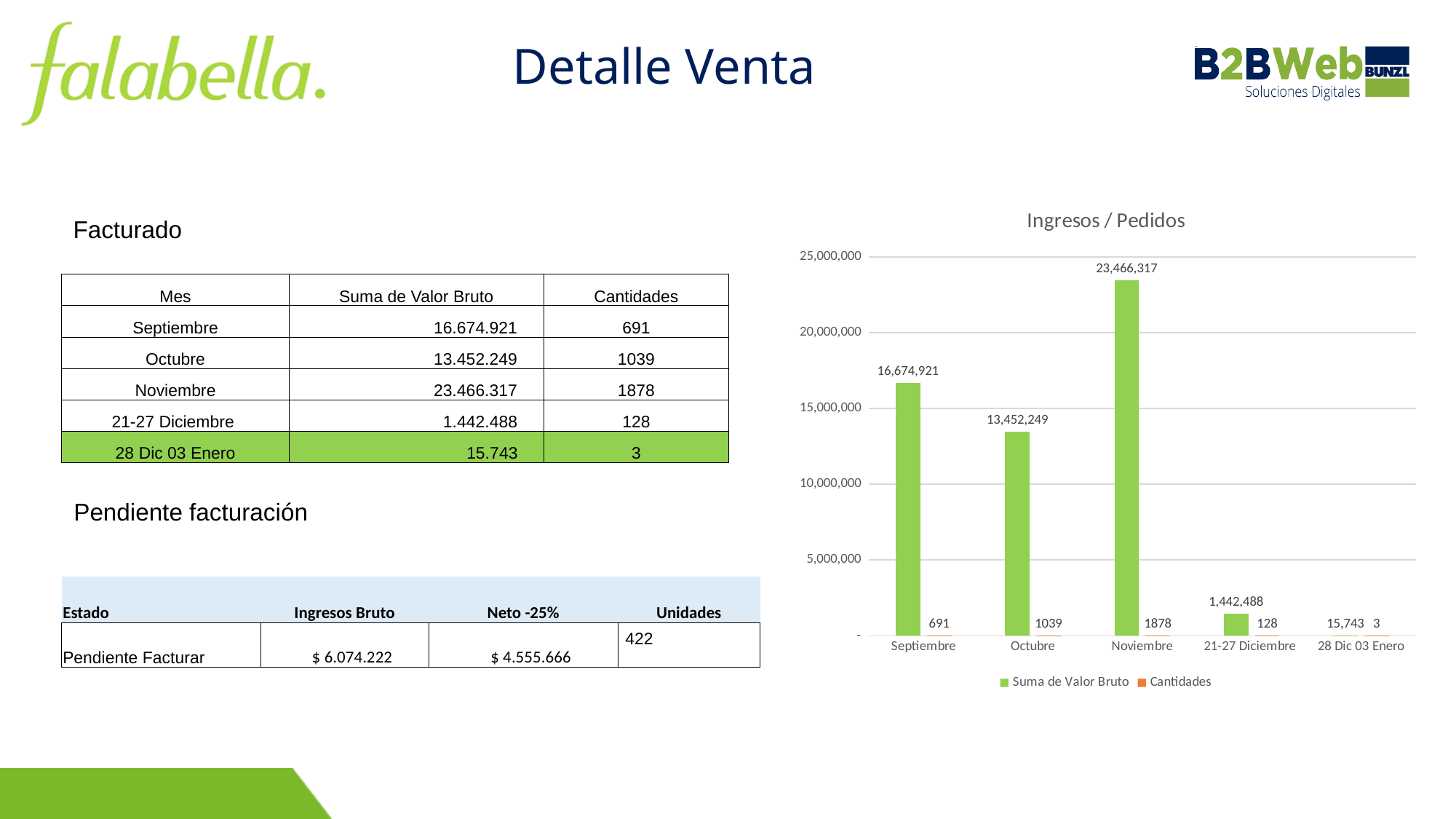
Which category has the lowest Cantidades value in the chart? 28 Dic 03 Enero How many series does the chart legend list? 2 What is the Suma de Valor Bruto value for 21-27 Diciembre in the chart? 1,442,488 Which is larger in the chart, the Suma de Valor Bruto for Septiembre or for Octubre? Septiembre What is the Cantidades value for Octubre in the chart? 1039 What is the Suma de Valor Bruto value for Noviembre in the chart? 23,466,317 What is the title of the chart? Ingresos / Pedidos How many categories are shown on the x axis of the chart? 5 What kind of chart is shown on the slide? bar chart What is the difference between the Suma de Valor Bruto for Septiembre and Octubre in the chart? 3,222,672 Is the Suma de Valor Bruto for Noviembre greater or less than 20,000,000? greater Which category has the highest Suma de Valor Bruto in the chart? Noviembre